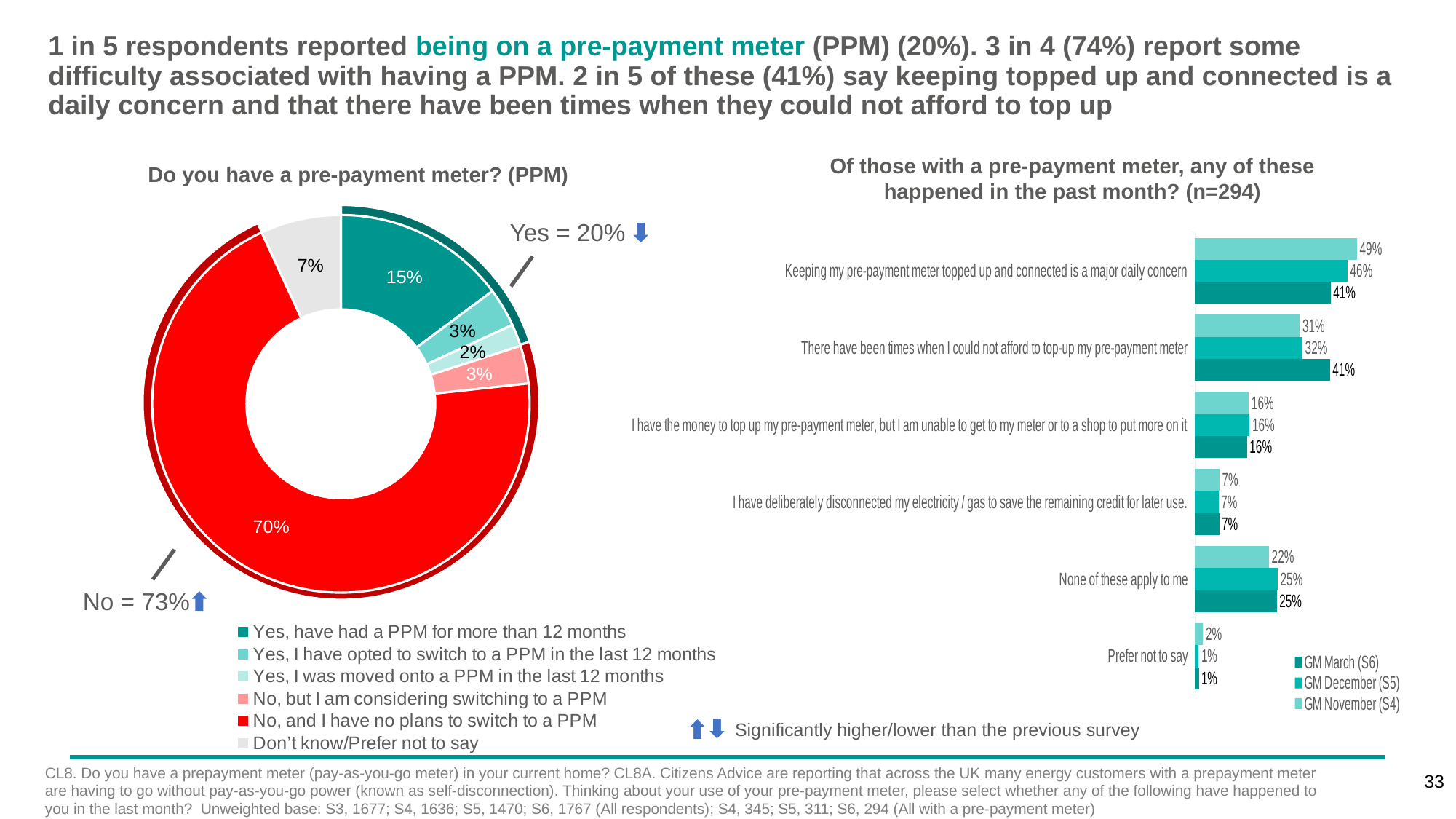
In the chart 'Of those with a pre-payment meter, any of these happened in the past month?', what is the GM March (S6) value for 'There have been times when I could not afford to top-up my pre-payment meter'? 41% In the chart 'Do you have a pre-payment meter? (PPM)', what percentage said 'Yes, have had a PPM for more than 12 months'? 15% In the chart 'Do you have a pre-payment meter? (PPM)', what share of the pie is 'Don't know/Prefer not to say'? 7% How many series does the legend list in the chart 'Of those with a pre-payment meter, any of these happened in the past month?'? 3 In the chart 'Of those with a pre-payment meter, any of these happened in the past month?', which category has the lowest GM March (S6) value? Prefer not to say What type of chart is 'Do you have a pre-payment meter? (PPM)'? Pie (donut) chart In the chart 'Of those with a pre-payment meter, any of these happened in the past month?', is the GM December (S5) value for 'None of these apply to me' larger or smaller than the GM November (S4) value? Larger In the chart 'Of those with a pre-payment meter, any of these happened in the past month?', what is the difference between the GM November (S4) and GM March (S6) values for 'Keeping my pre-payment meter topped up and connected is a major daily concern'? 8% In the chart 'Do you have a pre-payment meter? (PPM)', what is the combined 'Yes' percentage shown on the slide? 20% In the chart 'Of those with a pre-payment meter, any of these happened in the past month?', how many categories are shown? 6 In the chart 'Do you have a pre-payment meter? (PPM)', what percentage of respondents said 'No, and I have no plans to switch to a PPM'? 70% In the chart 'Of those with a pre-payment meter, any of these happened in the past month?', what is the GM November (S4) value for 'Keeping my pre-payment meter topped up and connected is a major daily concern'? 49%